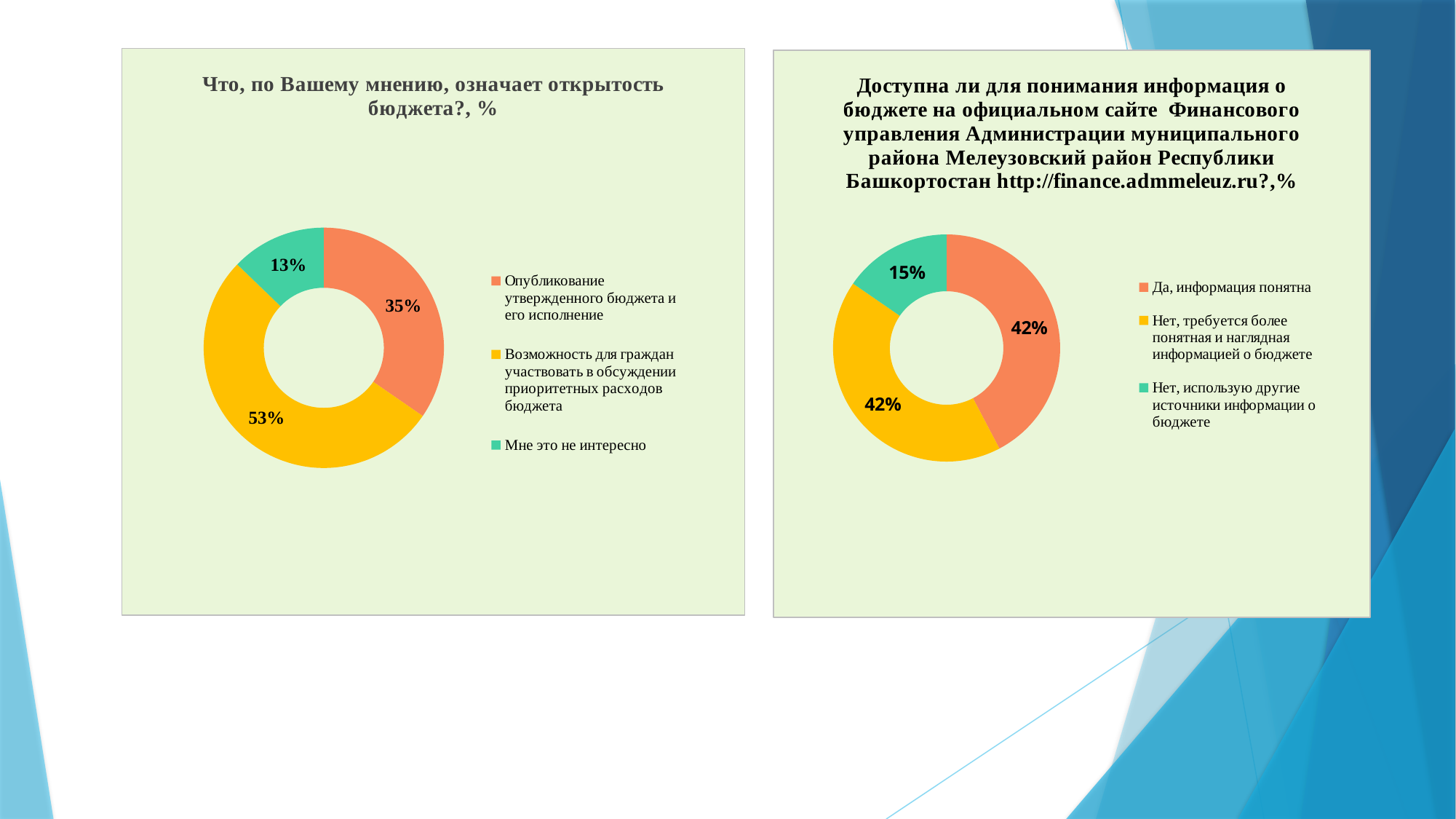
In the right chart, which is larger: the share for "Да, информация понятна" or the share for "Нет, использую другие источники информации о бюджете"? Да, информация понятна What type of chart is the left chart? Doughnut chart In the right chart, what colour is the slice for "Нет, требуется более понятная и наглядная информацией о бюджете"? Yellow In the left chart, what percentage corresponds to "Опубликование утвержденного бюджета и его исполнение"? 35% In the right chart, what percentage corresponds to "Нет, использую другие источники информации о бюджете"? 15% In the left chart, what is the difference between the share for "Возможность для граждан участвовать в обсуждении приоритетных расходов бюджета" and the share for "Опубликование утвержденного бюджета и его исполнение"? 18% In the right chart, what percentage corresponds to "Да, информация понятна"? 42% In the left chart, which category has the smallest share? Мне это не интересно In the right chart, which category has the smallest share? Нет, использую другие источники информации о бюджете In the left chart, what percentage corresponds to "Мне это не интересно"? 13% In the left chart, how many categories are shown? 3 In the left chart, which category has the largest share? Возможность для граждан участвовать в обсуждении приоритетных расходов бюджета